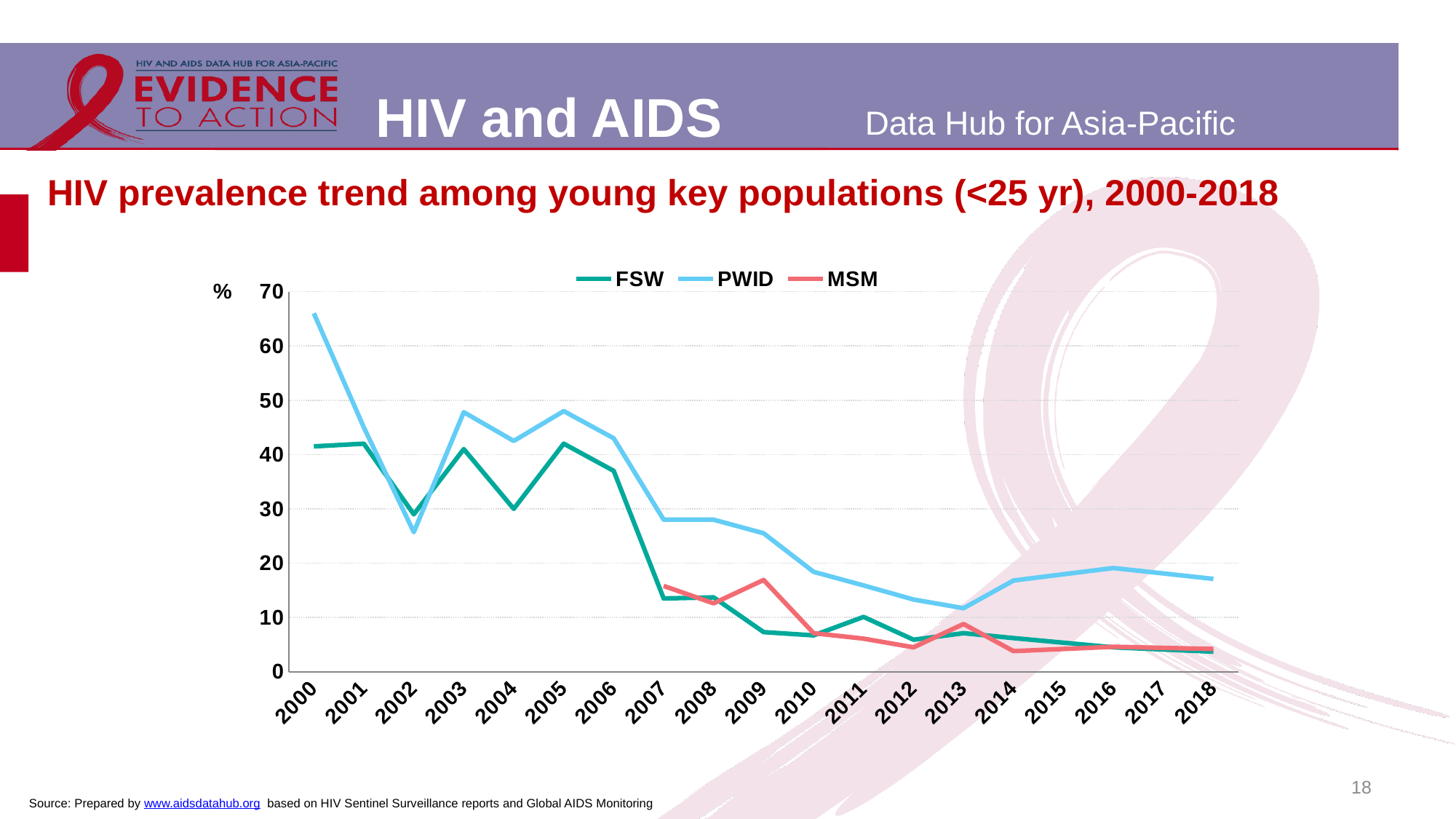
In which year does the PWID series reach its highest value? 2000 Is the FSW value for 2007 greater or less than 20? less How many series does the legend list? 3 Is the FSW value for 2018 greater or less than 10? less Which series has the highest value in 2000? PWID Is the PWID value for 2018 greater or less than 10? greater In 2018, which is larger: the PWID value or the FSW value? PWID What kind of chart is shown on the slide? line chart In 2009, which is larger: the MSM value or the FSW value? MSM Overall, does the FSW series rise or fall from 2000 to 2018? fall How many years are shown along the x axis? 19